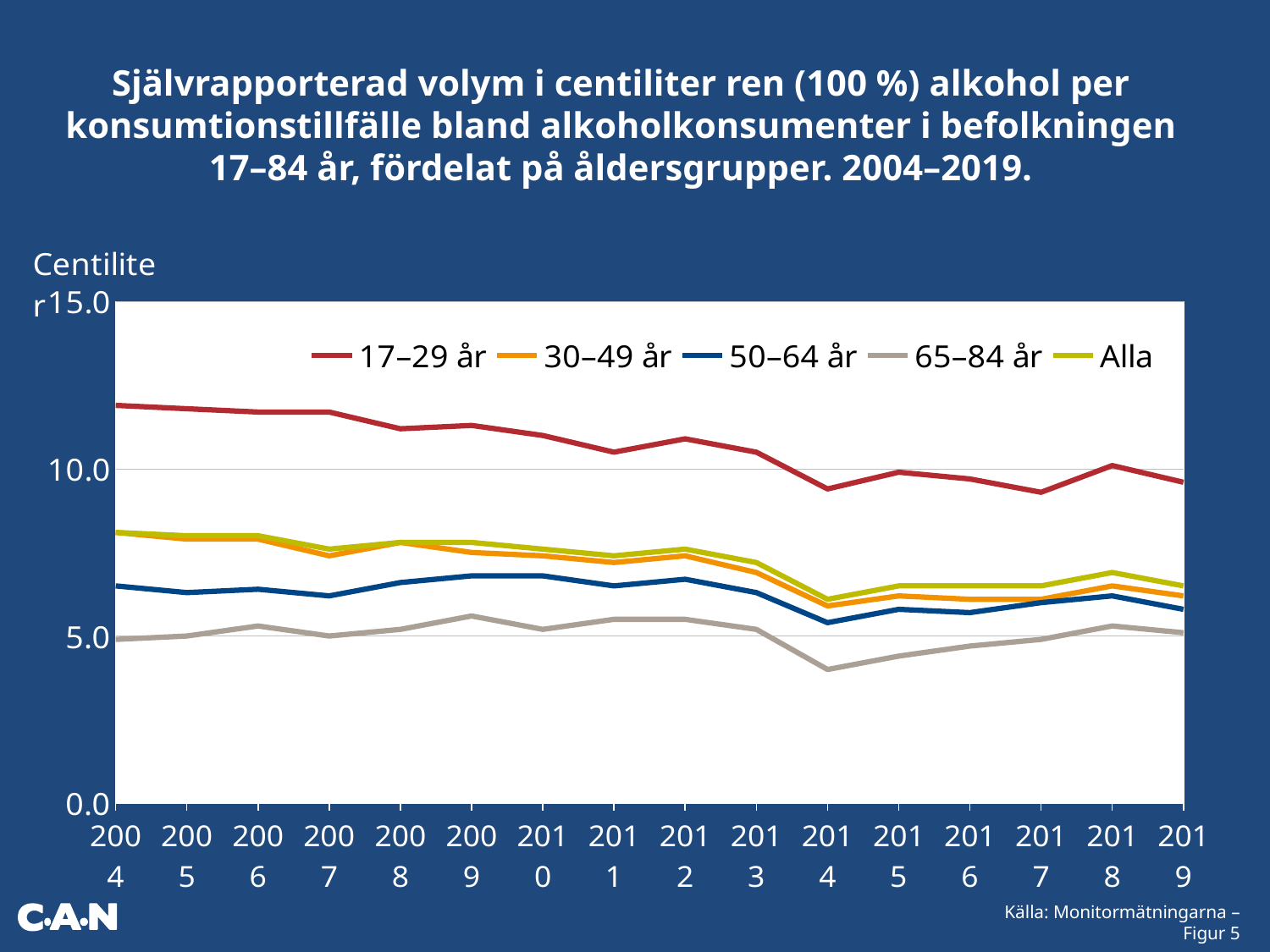
Which age group has the highest values across the whole period? 17–29 år What is the label on the vertical axis of the chart? Centiliter What kind of chart is shown on the slide? line chart Which age group has the lowest values across the whole period? 65–84 år How many years are plotted along the x axis? 16 Is the value for 17–29 år in 2014 greater or less than 10.0? less Is the value for 50–64 år in 2004 greater or less than 5.0? greater In 2004, which is larger: the value for 50–64 år or the value for 65–84 år? 50–64 år Is the value for 17–29 år in 2004 greater or less than 10.0? greater Does the line for 17–29 år rise or fall overall from 2004 to 2019? fall How many series does the legend list? 5